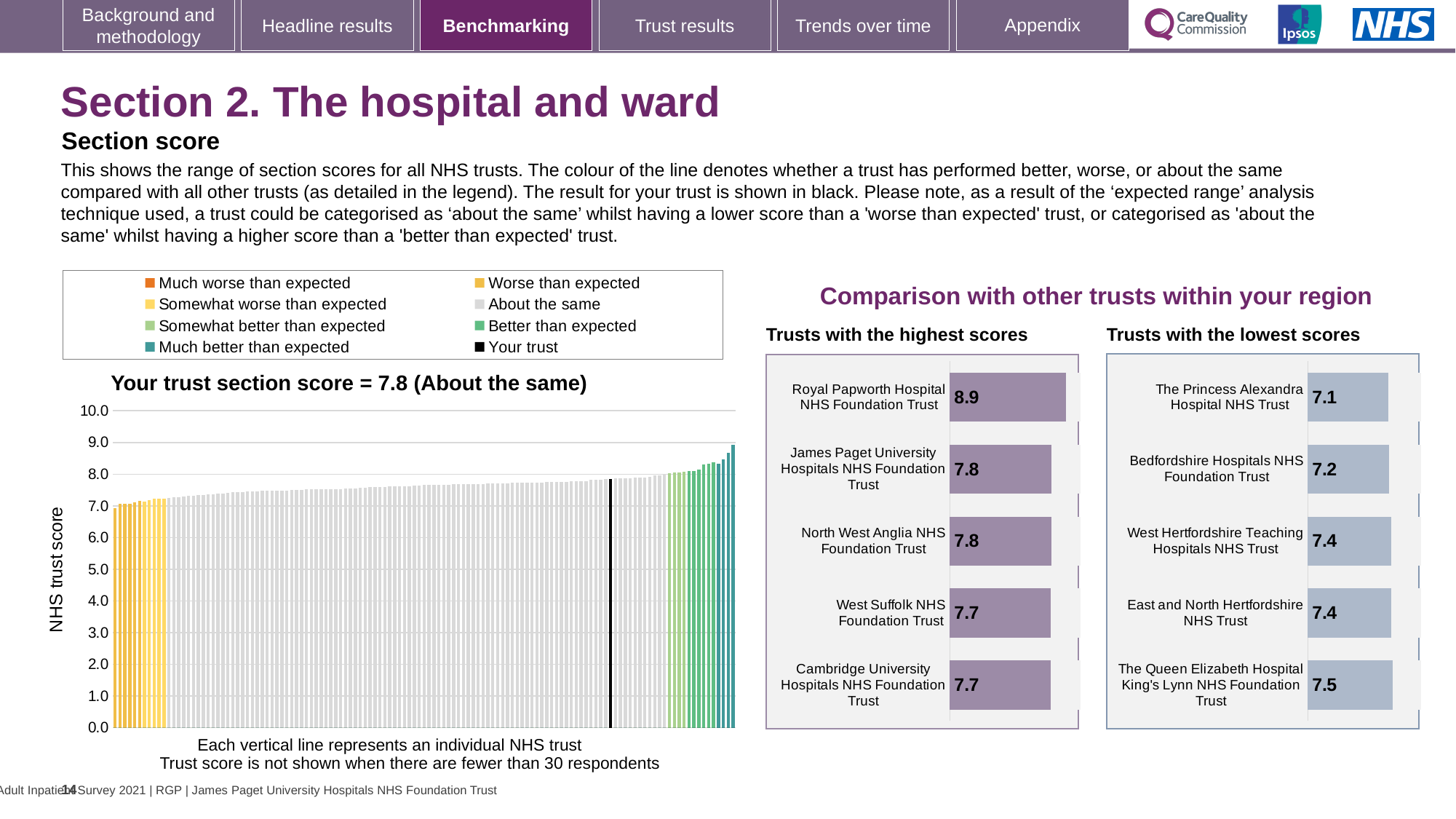
What kind of chart is the main 'Your trust section score' chart? bar chart In the 'Trusts with the highest scores' chart, which trust has the highest score? Royal Papworth Hospital NHS Foundation Trust In the main section score chart, is the value of the tallest bar greater or less than 8.0? greater In the 'Trusts with the lowest scores' chart, which trust has the lowest score? The Princess Alexandra Hospital NHS Trust How many entries does the legend of the main section score chart list? 8 How many trusts are listed in the 'Trusts with the highest scores' chart? 5 According to the main chart's title, what is your trust's section score? 7.8 In the 'Trusts with the lowest scores' chart, what is the score for The Princess Alexandra Hospital NHS Trust? 7.1 In the 'Trusts with the highest scores' chart, what is the difference between the scores of Royal Papworth Hospital NHS Foundation Trust and Cambridge University Hospitals NHS Foundation Trust? 1.2 In the 'Trusts with the lowest scores' chart, which has the higher score: Bedfordshire Hospitals NHS Foundation Trust or West Hertfordshire Teaching Hospitals NHS Trust? West Hertfordshire Teaching Hospitals NHS Trust In the 'Trusts with the highest scores' chart, what is the score for Royal Papworth Hospital NHS Foundation Trust? 8.9 In the 'Trusts with the lowest scores' chart, what is the difference between the scores of The Queen Elizabeth Hospital King's Lynn NHS Foundation Trust and The Princess Alexandra Hospital NHS Trust? 0.4